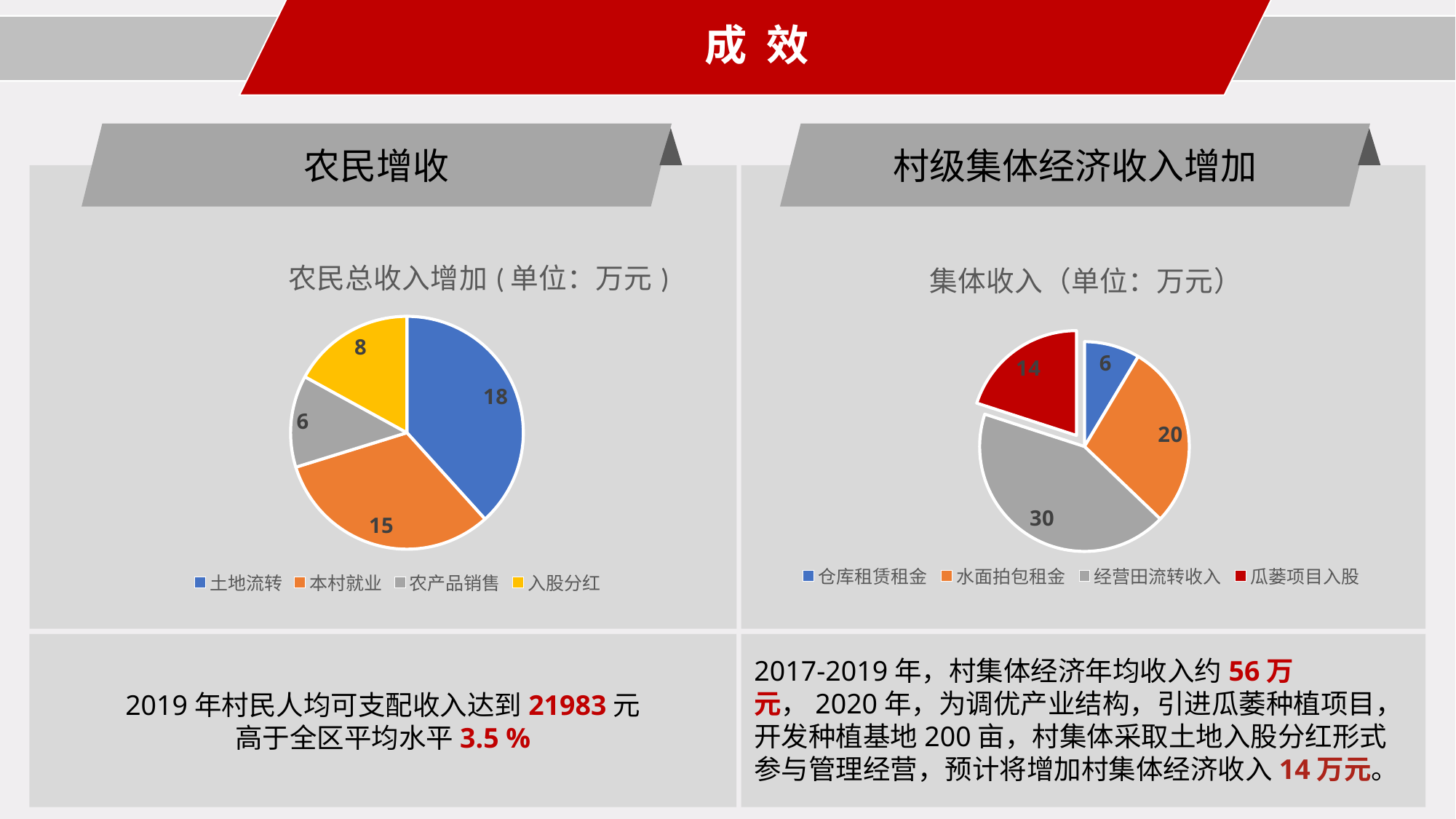
In the chart titled 农民总收入增加（单位：万元）, what is the value for 农产品销售? 6 In the chart titled 农民总收入增加（单位：万元）, which category has the largest value? 土地流转 In the chart titled 集体收入（单位：万元）, what is the value for 经营田流转收入? 30 In the chart titled 集体收入（单位：万元）, what is the value for 瓜蒌项目入股? 14 In the chart titled 集体收入（单位：万元）, which category has the smallest value? 仓库租赁租金 In the chart titled 农民总收入增加（单位：万元）, how many categories does the legend list? 4 In the chart titled 农民总收入增加（单位：万元）, which category has the smallest value? 农产品销售 In the chart titled 集体收入（单位：万元）, which is larger, 水面拍包租金 or 瓜蒌项目入股? 水面拍包租金 In the chart titled 集体收入（单位：万元）, what share of the total does 瓜蒌项目入股 represent? 20% In the chart titled 农民总收入增加（单位：万元）, what is the difference between the values for 本村就业 and 入股分红? 7 In the chart titled 农民总收入增加（单位：万元）, what is the value for 土地流转? 18 What type of chart is used on the right side of the slide, titled 集体收入（单位：万元）? Pie chart